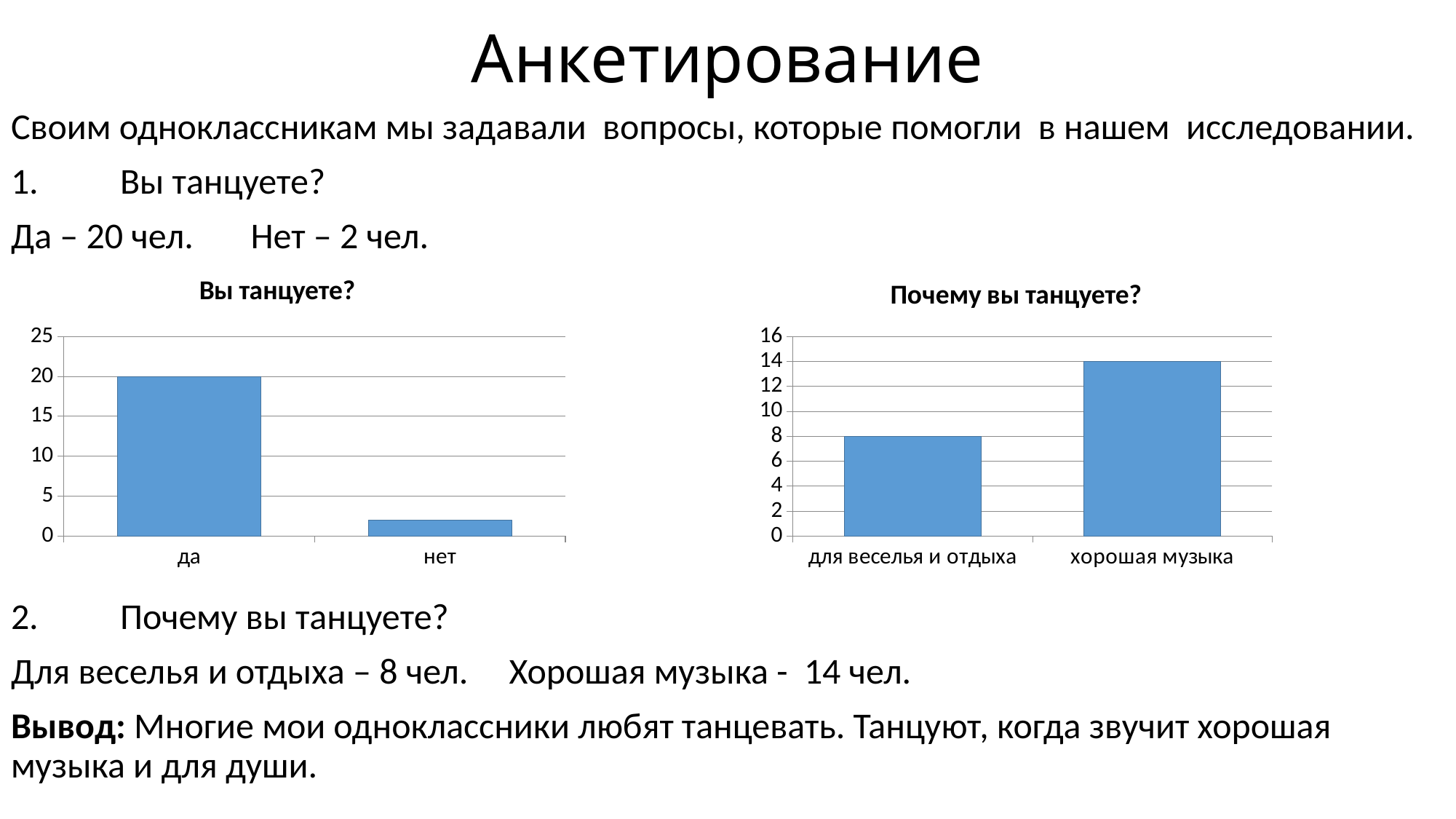
In the chart titled "Вы танцуете?", how many categories are shown on the x axis? 2 In the chart titled "Почему вы танцуете?", what is the value for "хорошая музыка"? 14 In the chart titled "Почему вы танцуете?", which category has the lowest value? для веселья и отдыха In the chart titled "Почему вы танцуете?", is the value for "хорошая музыка" greater or less than 10? greater In the chart titled "Вы танцуете?", what is the value for "да"? 20 What is the title of the chart on the right side of the slide? Почему вы танцуете? In the chart titled "Почему вы танцуете?", which is larger: "для веселья и отдыха" or "хорошая музыка"? хорошая музыка In the chart titled "Вы танцуете?", which category has the highest value? да In the chart titled "Почему вы танцуете?", what is the value for "для веселья и отдыха"? 8 What kind of chart is the chart titled "Вы танцуете?"? bar chart In the chart titled "Вы танцуете?", is the value for "нет" greater or less than 5? less In the chart titled "Почему вы танцуете?", what is the difference between the values for "хорошая музыка" and "для веселья и отдыха"? 6